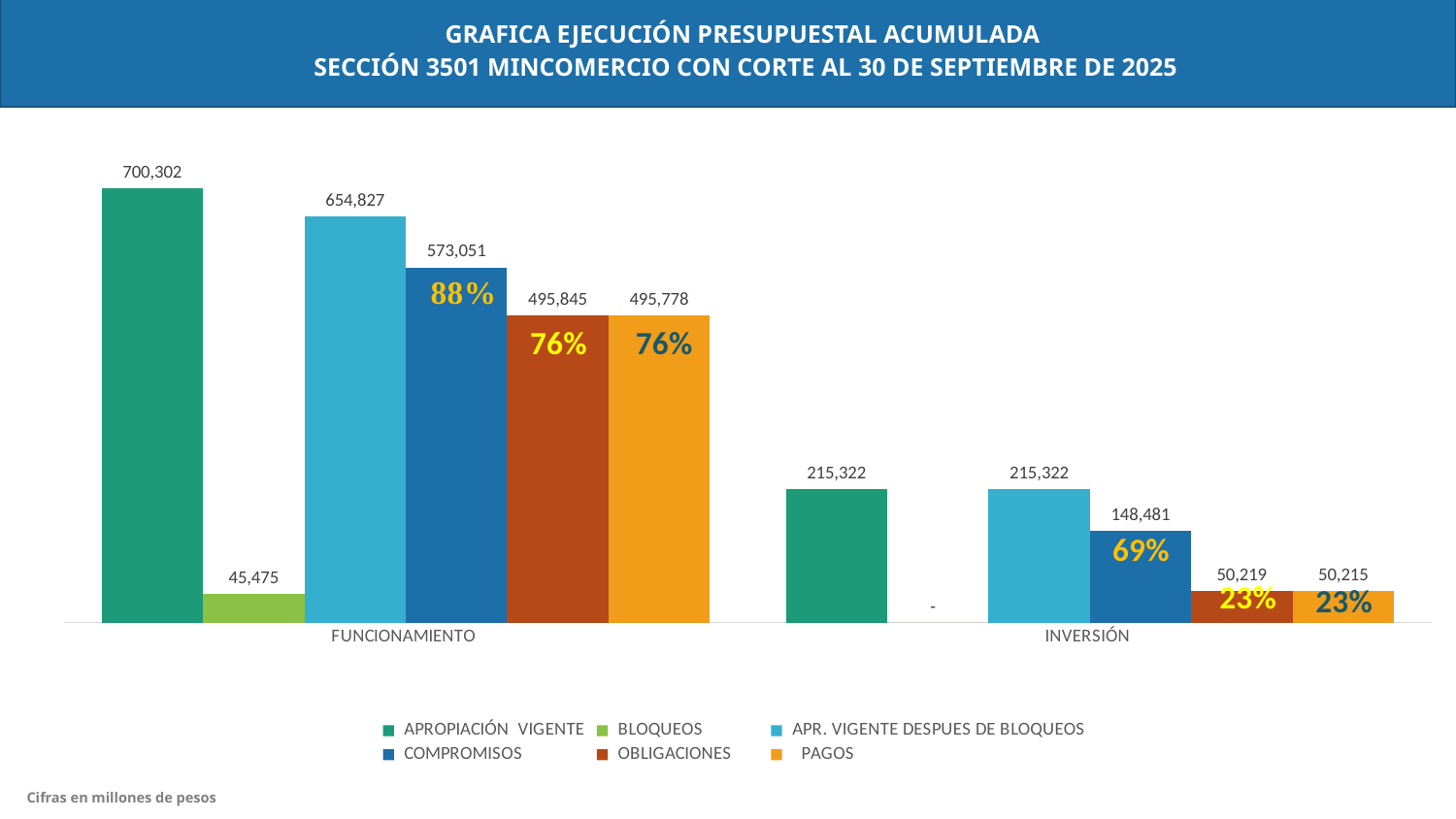
What is the value of PAGOS for INVERSIÓN? 50,215 What is the value of COMPROMISOS for INVERSIÓN? 148,481 Which series has the highest value for INVERSIÓN? APROPIACIÓN VIGENTE and APR. VIGENTE DESPUES DE BLOQUEOS (both 215,322) How many categories are shown on the x axis? 2 What is the value of APROPIACIÓN VIGENTE for FUNCIONAMIENTO? 700,302 How many series does the legend list? 6 What is the difference between APROPIACIÓN VIGENTE and APR. VIGENTE DESPUES DE BLOQUEOS for FUNCIONAMIENTO? 45,475 Which series has the lowest value for FUNCIONAMIENTO? BLOQUEOS Which is larger: COMPROMISOS for FUNCIONAMIENTO or COMPROMISOS for INVERSIÓN? COMPROMISOS for FUNCIONAMIENTO What percentage is shown on the COMPROMISOS bar for FUNCIONAMIENTO? 88% What is the value of BLOQUEOS for FUNCIONAMIENTO? 45,475 What kind of chart is shown on the slide? Bar chart